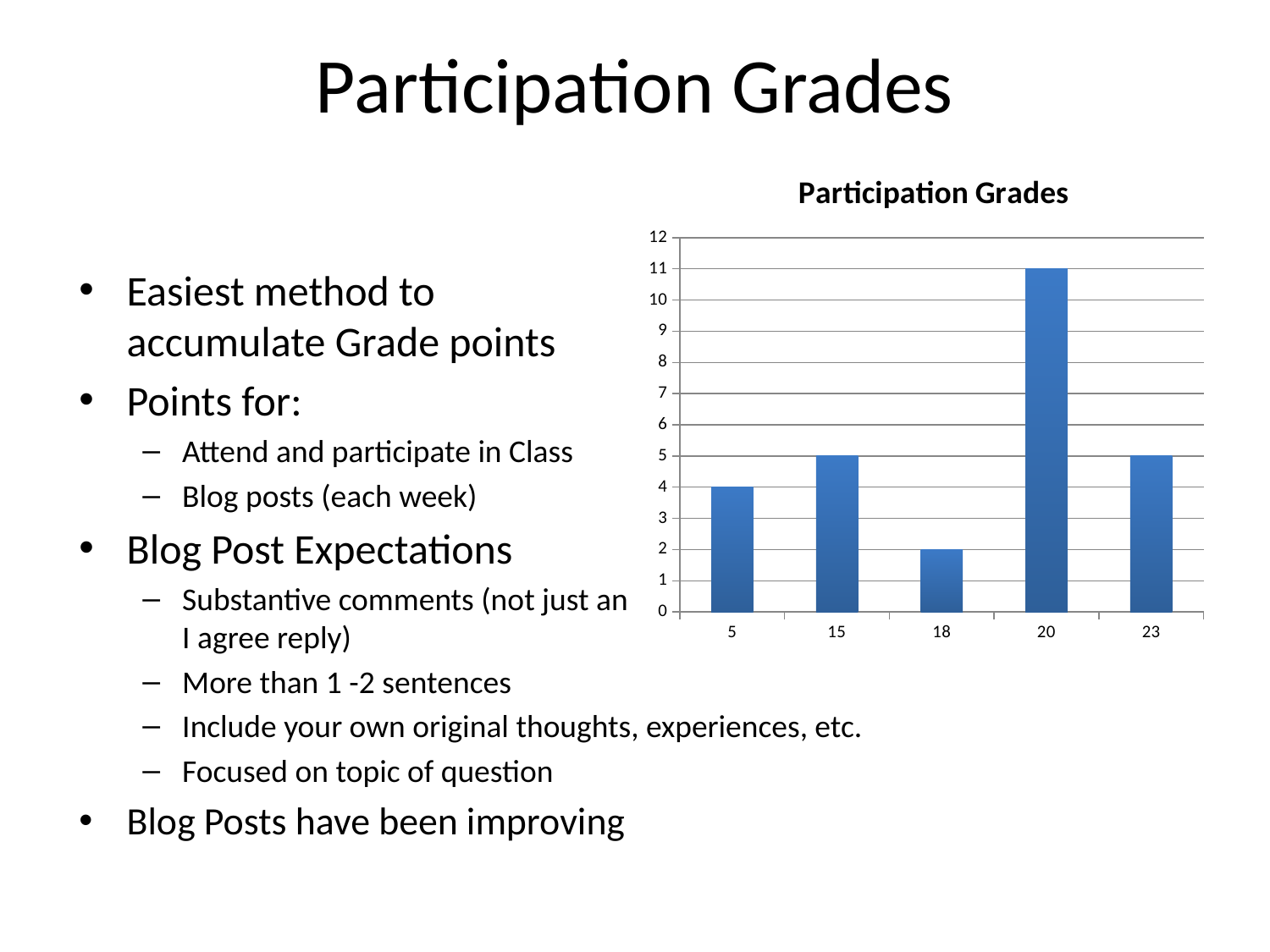
Which category has the highest value? 20 What type of chart is shown on the slide? bar chart What is the value for category 20? 11 What is the value for category 5? 4 What is the value for category 18? 2 What is the title of the chart? Participation Grades What is the maximum value shown on the vertical axis? 12 What is the difference between the values for categories 20 and 18? 9 Which category has the lowest value? 18 How many bars are plotted in the chart? 5 Which has a larger value, category 5 or category 15? 15 Is the value for category 20 greater or less than 10? greater